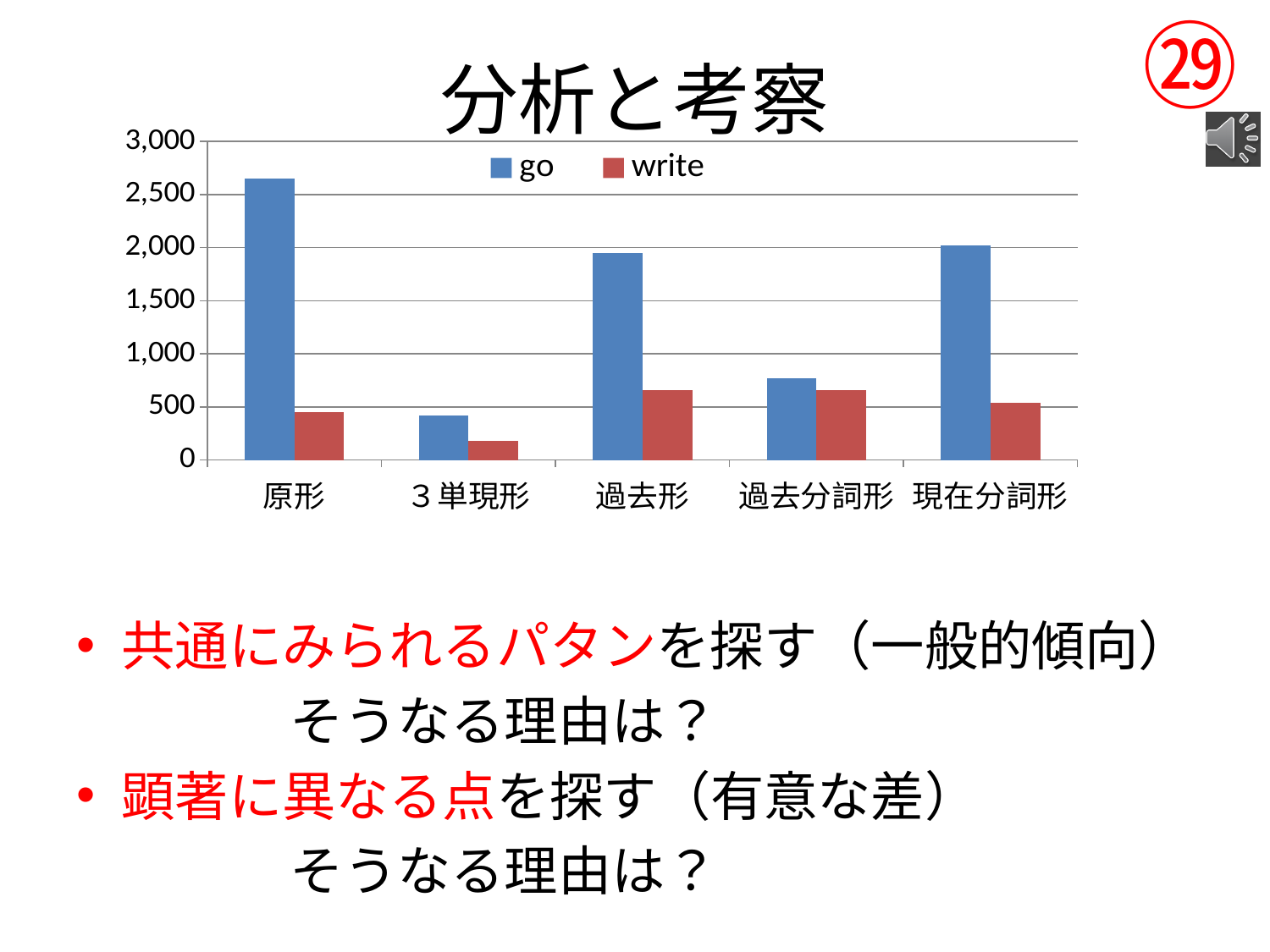
Which category has the highest value for the go series? 原形 Which category has the lowest value for the go series? ３単現形 How many series does the chart's legend list? 2 Is the value for go in the 過去形 category greater or less than 2,000? less Is the value for go in the 原形 category greater or less than 2,500? greater Is the value for go in the ３単現形 category greater or less than 500? less How many categories are shown on the x axis of the chart? 5 Which series is shown in blue in the chart? go Which category has the lowest value for the write series? ３単現形 What kind of chart is shown on the slide? bar chart Which is larger for the go series: the value for 原形 or the value for 現在分詞形? 原形